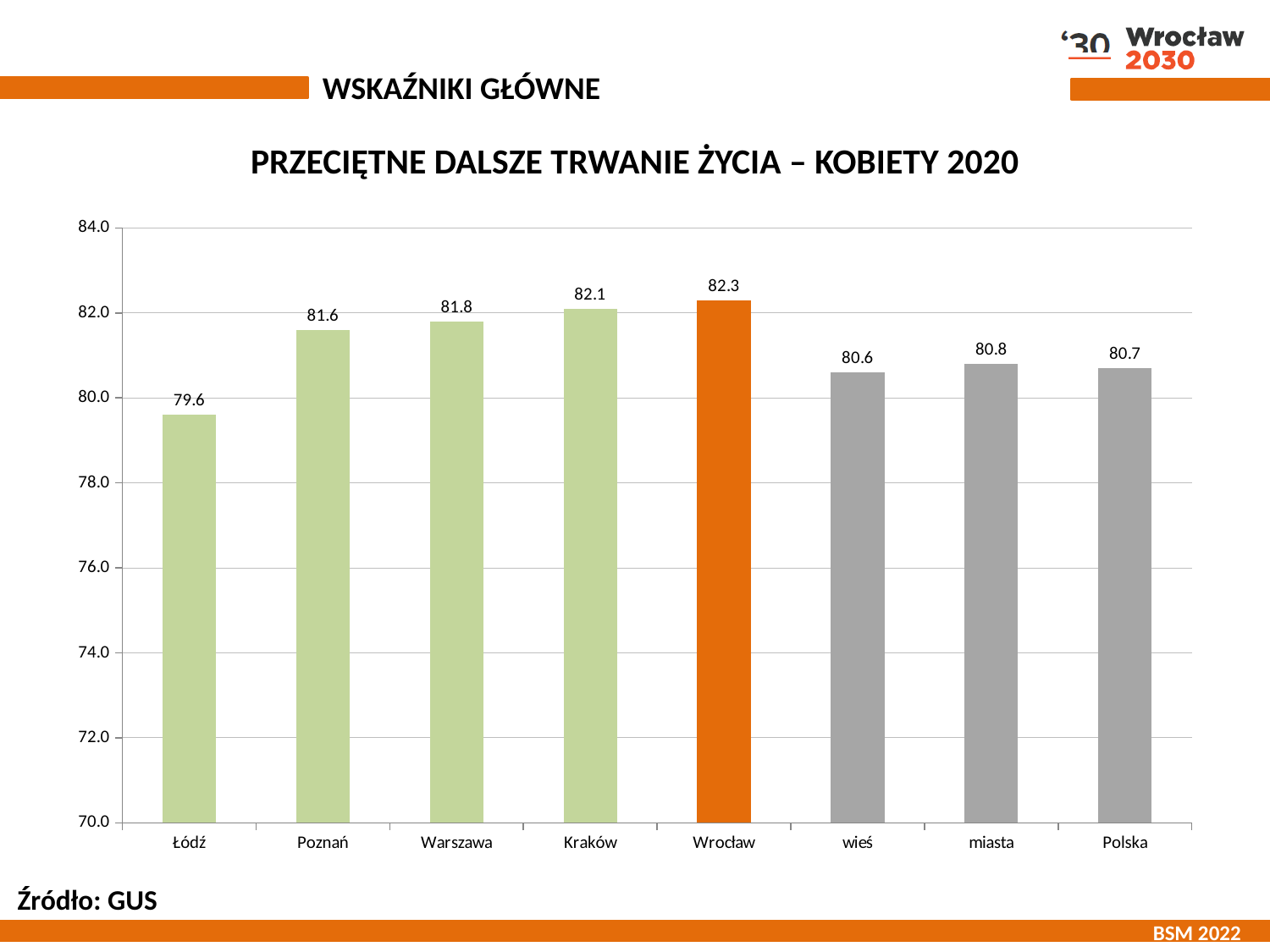
What is the difference between the values for Wrocław and Łódź? 2.7 What is the value for Polska? 80.7 What colour is the bar for Wrocław? orange Is the value for wieś greater or less than 82.0? less What is the difference between the values for Kraków and Warszawa? 0.3 What is the value for Łódź? 79.6 What kind of chart is shown on the slide? bar chart Which is larger, the value for Poznań or the value for miasta? Poznań How many categories are shown on the x axis? 8 Which category has the lowest value? Łódź What is the value for Wrocław? 82.3 Which category has the highest value? Wrocław